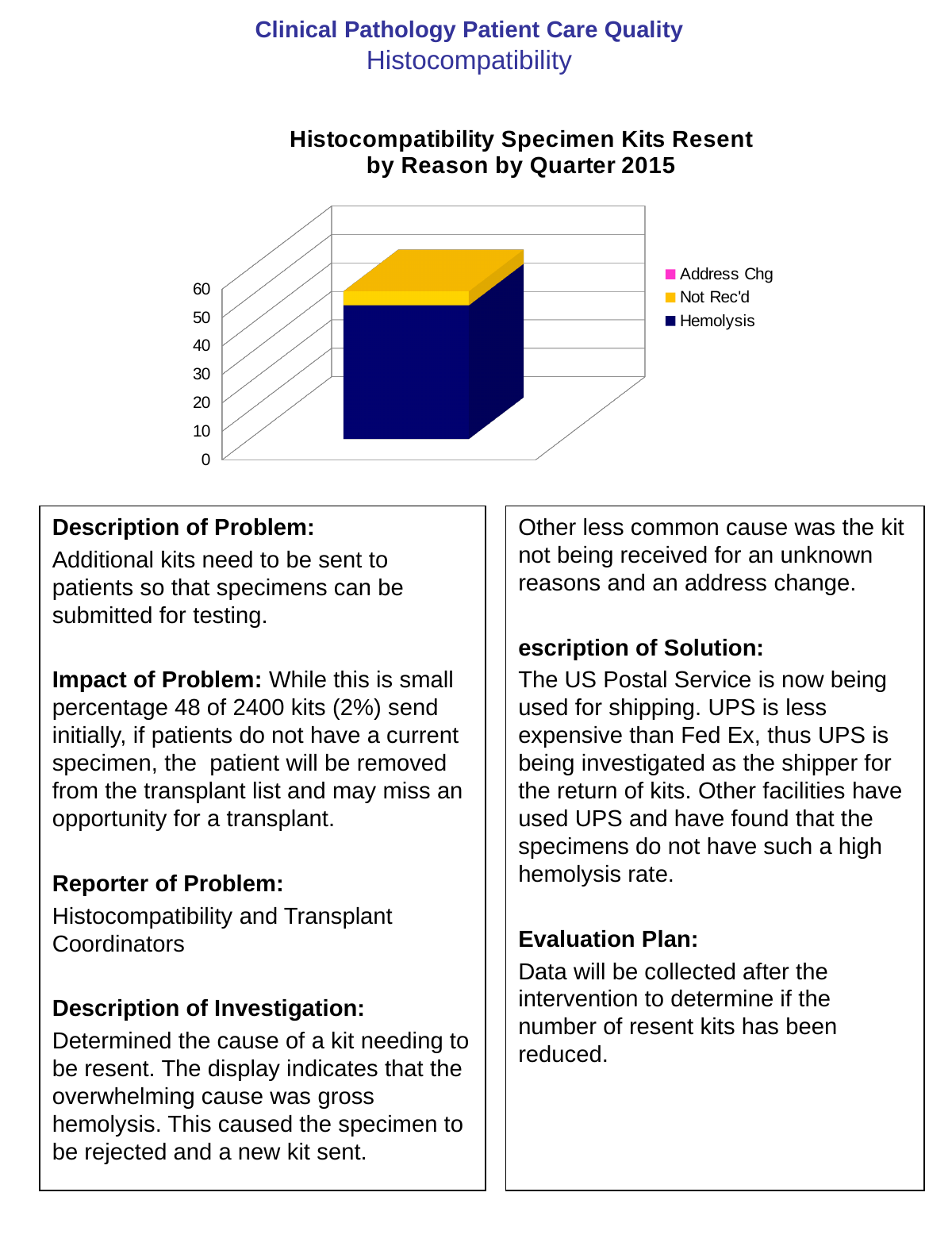
Is the value for Hemolysis greater or less than 30? greater Is the value for Not Rec'd greater or less than 20? less Which is larger in the stacked bar, Hemolysis or Not Rec'd? Hemolysis How many bars are plotted in the chart? 1 What is the highest value shown on the vertical axis of the chart? 60 What kind of chart is shown on the slide? bar chart What is the title of the chart? Histocompatibility Specimen Kits Resent by Reason by Quarter 2015 Is the value for Hemolysis greater or less than 20? greater Which series is shown in yellow in the chart legend? Not Rec'd Which series accounts for the largest portion of the stacked bar? Hemolysis How many series does the chart legend list? 3